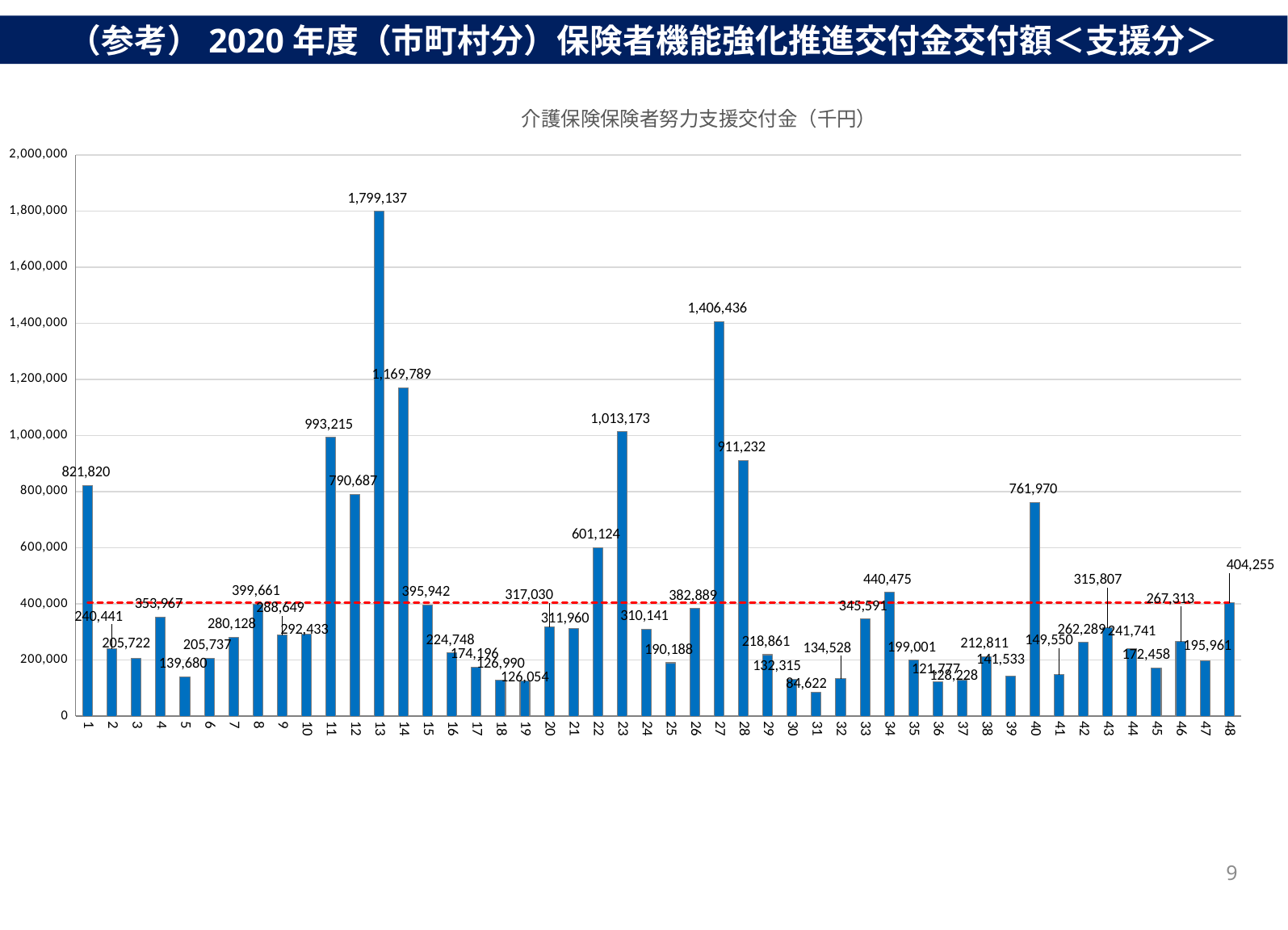
What is the difference between the values for category 13 and category 27? 392,701 What is the value for category 27? 1,406,436 What is the value for category 40? 761,970 What is the title of the chart? 介護保険保険者努力支援交付金（千円） Which is larger, the value for category 14 or category 23? 14 Is the value for category 22 greater or less than 400,000? greater What is the value for category 13? 1,799,137 Which category has the lowest value? 31 What kind of chart is shown on the slide? bar chart What is the difference between the values for category 28 and category 12? 120,545 How many categories are shown on the x axis? 48 Which category has the highest value? 13